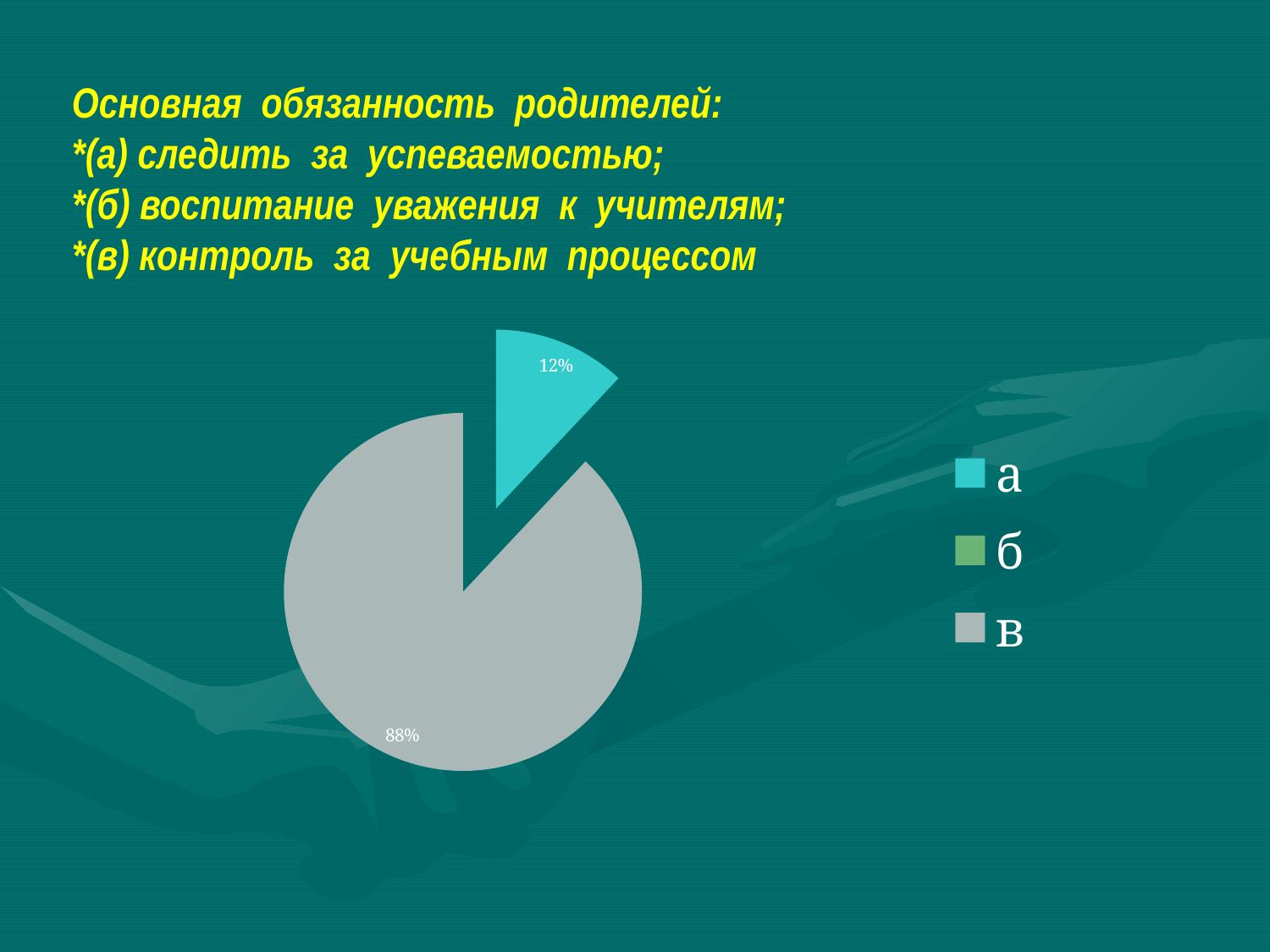
What is the difference in percentage points between the "в" slice and the "а" slice? 76 What type of chart is shown on the slide? pie chart Which slice is larger, "а" or "в"? в How many slices with data labels are visible in the pie chart? 2 What share of the pie does the grey slice represent? 88% What colour is the slice labelled "а" in the pie chart? teal What percentage is shown for the slice labelled "а" in the pie chart? 12% Which of the two labelled slices, "а" or "в", is smaller? а What percentage is shown for the slice labelled "в" in the pie chart? 88% Which legend entry corresponds to the largest slice of the pie chart? в How many entries does the legend of the pie chart list? 3 Which legend entry is shown with a green marker? б